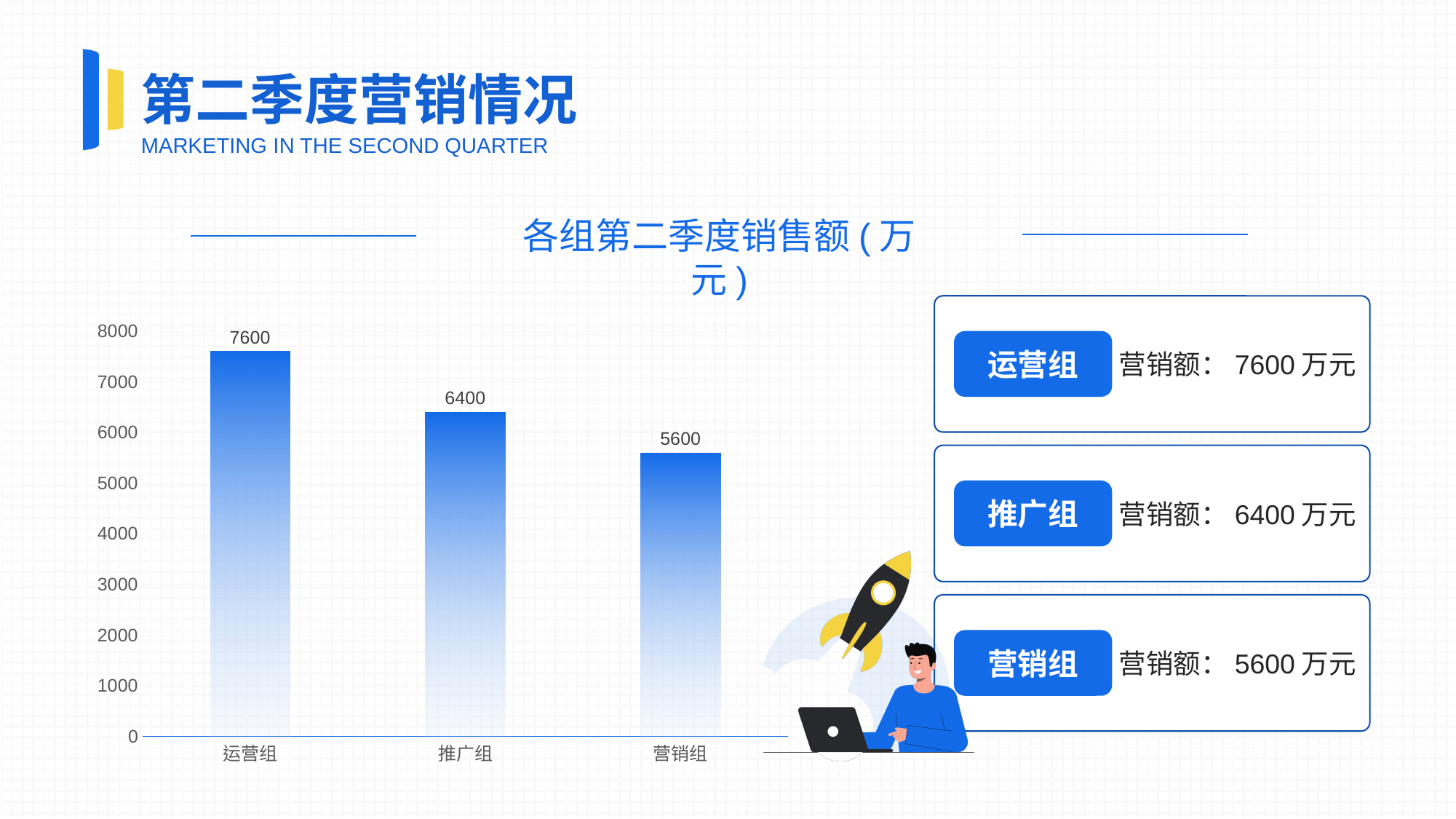
What is the value for 营销组? 5600 What kind of chart is shown? bar chart What is the value for 推广组? 6400 Which group has the lowest value? 营销组 What is the value for 运营组? 7600 What is the difference between the values for 推广组 and 营销组? 800 Is the value for 推广组 greater or less than 6000? greater Which group has the highest value? 运营组 Do the values rise or fall from left to right along the x axis? fall How many groups are shown on the x axis? 3 Which is larger, the value for 推广组 or 营销组? 推广组 What is the difference between the values for 运营组 and 营销组? 2000